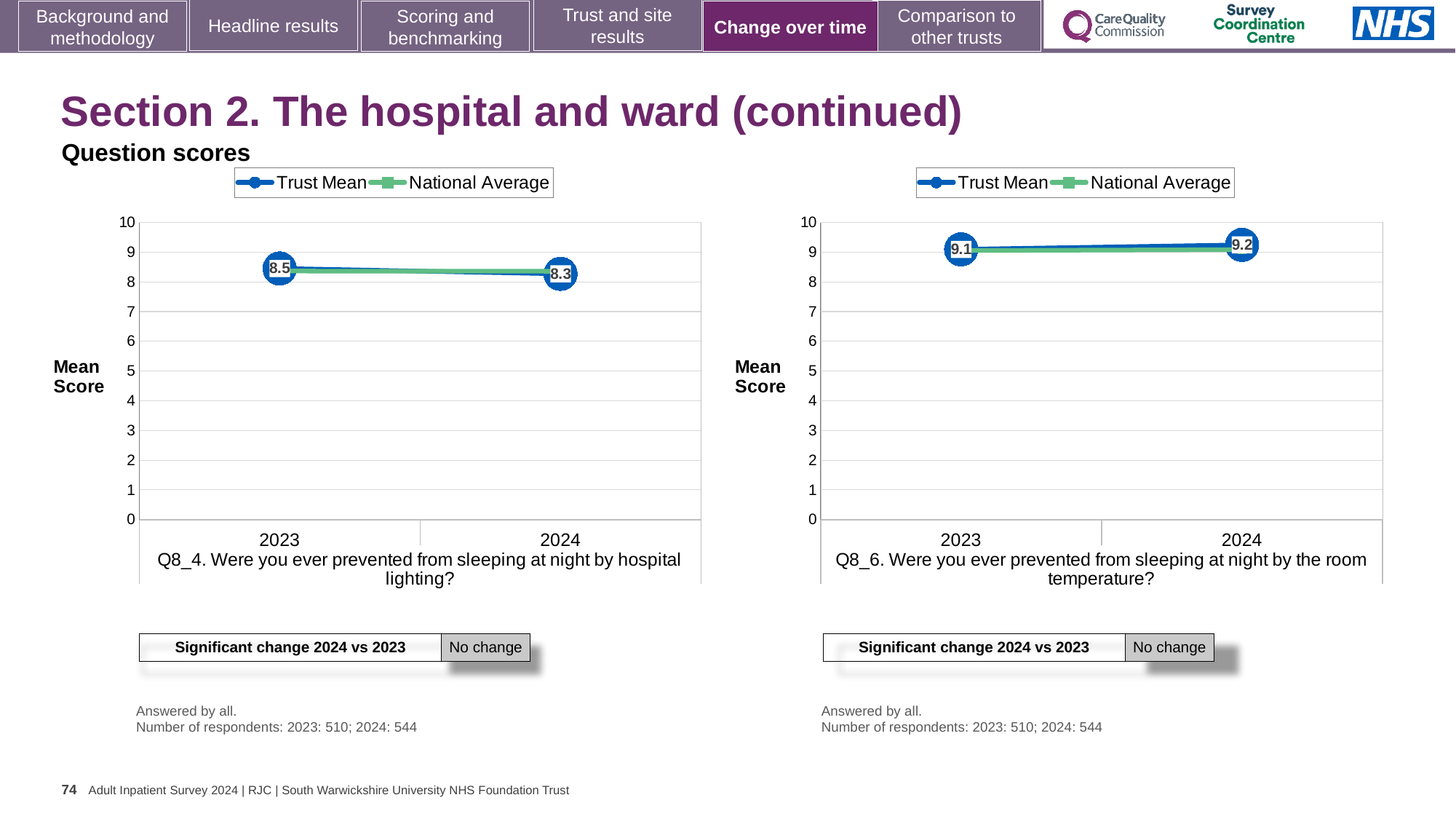
In the left chart (Q8_4, hospital lighting), what is the Trust Mean score for 2024? 8.3 In the left chart (Q8_4, hospital lighting), does the Trust Mean rise or fall from 2023 to 2024? fall In the left chart (Q8_4, hospital lighting), by how much did the Trust Mean change from 2023 to 2024? 0.2 In the right chart (Q8_6, room temperature), what is the difference between the Trust Mean scores for 2024 and 2023? 0.1 In the right chart (Q8_6, room temperature), what is the Trust Mean score for 2024? 9.2 In the right chart (Q8_6, room temperature), does the Trust Mean rise or fall from 2023 to 2024? rise What kind of chart is used on this slide? line chart How many series does the legend of the left chart list? 2 In the left chart (Q8_4, hospital lighting), what is the Trust Mean score for 2023? 8.5 In the left chart (Q8_4, hospital lighting), is the Trust Mean for 2024 greater or less than 8? greater How many years are plotted on the x axis of the right chart (Q8_6, room temperature)? 2 In the right chart (Q8_6, room temperature), what is the Trust Mean score for 2023? 9.1